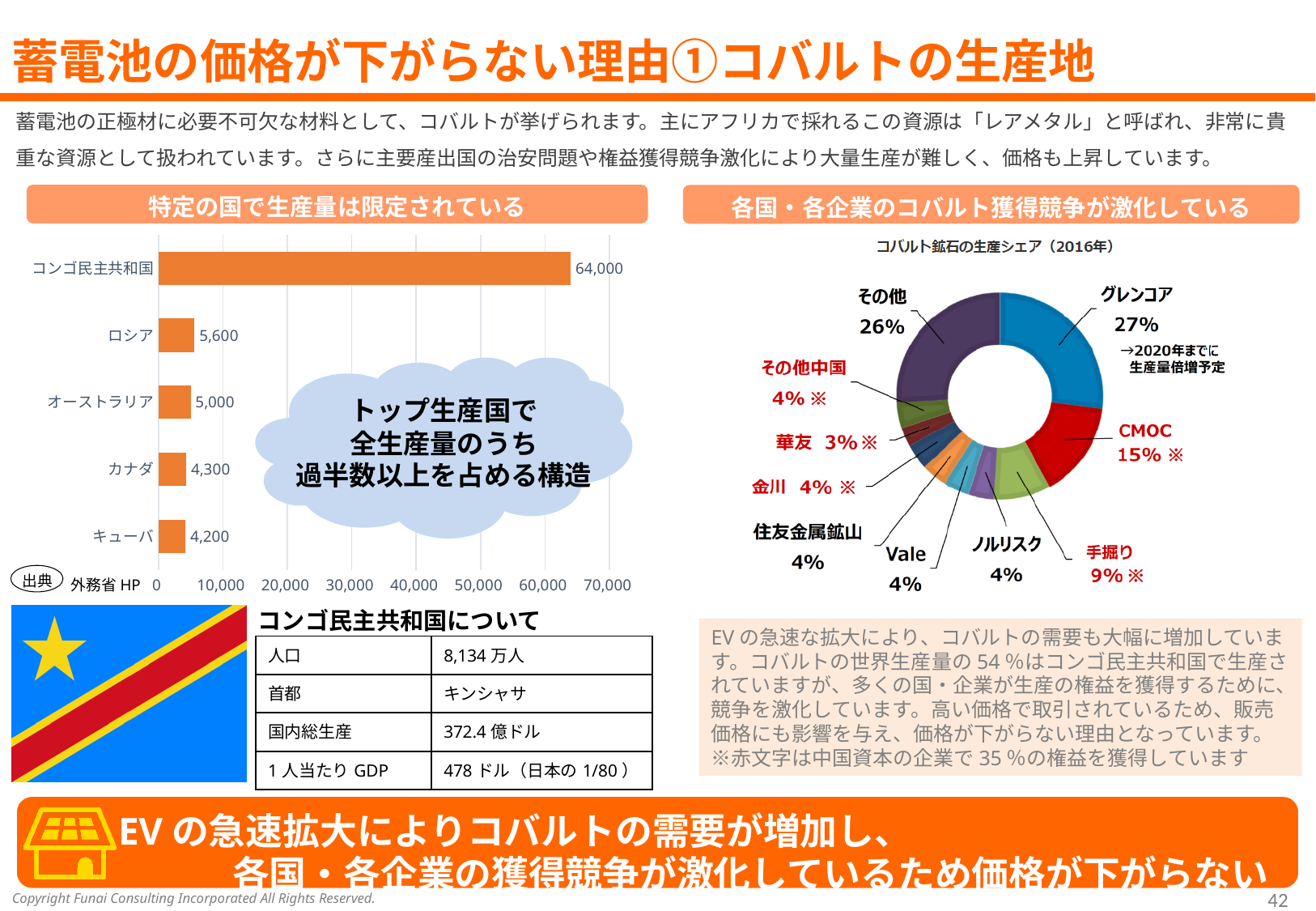
In the bar chart on the left, what is the difference between the values for ロシア and オーストラリア? 600 In the chart titled コバルト鉱石の生産シェア（2016年）, how many slices are there? 10 In the chart titled コバルト鉱石の生産シェア（2016年）, what share does CMOC hold? 15% In the chart titled コバルト鉱石の生産シェア（2016年）, what share does グレンコア hold? 27% In the bar chart on the left, what is the value for カナダ? 4,300 What kind of chart is the chart on the left? bar chart What kind of chart is the chart titled コバルト鉱石の生産シェア（2016年）? donut chart In the bar chart on the left, how many countries are shown? 5 In the chart titled コバルト鉱石の生産シェア（2016年）, which is larger, 手掘り or 華友? 手掘り In the bar chart on the left, what is the value for コンゴ民主共和国? 64,000 In the bar chart on the left, which country has the lowest value? キューバ In the bar chart on the left, is the value for コンゴ民主共和国 greater or less than 60,000? greater